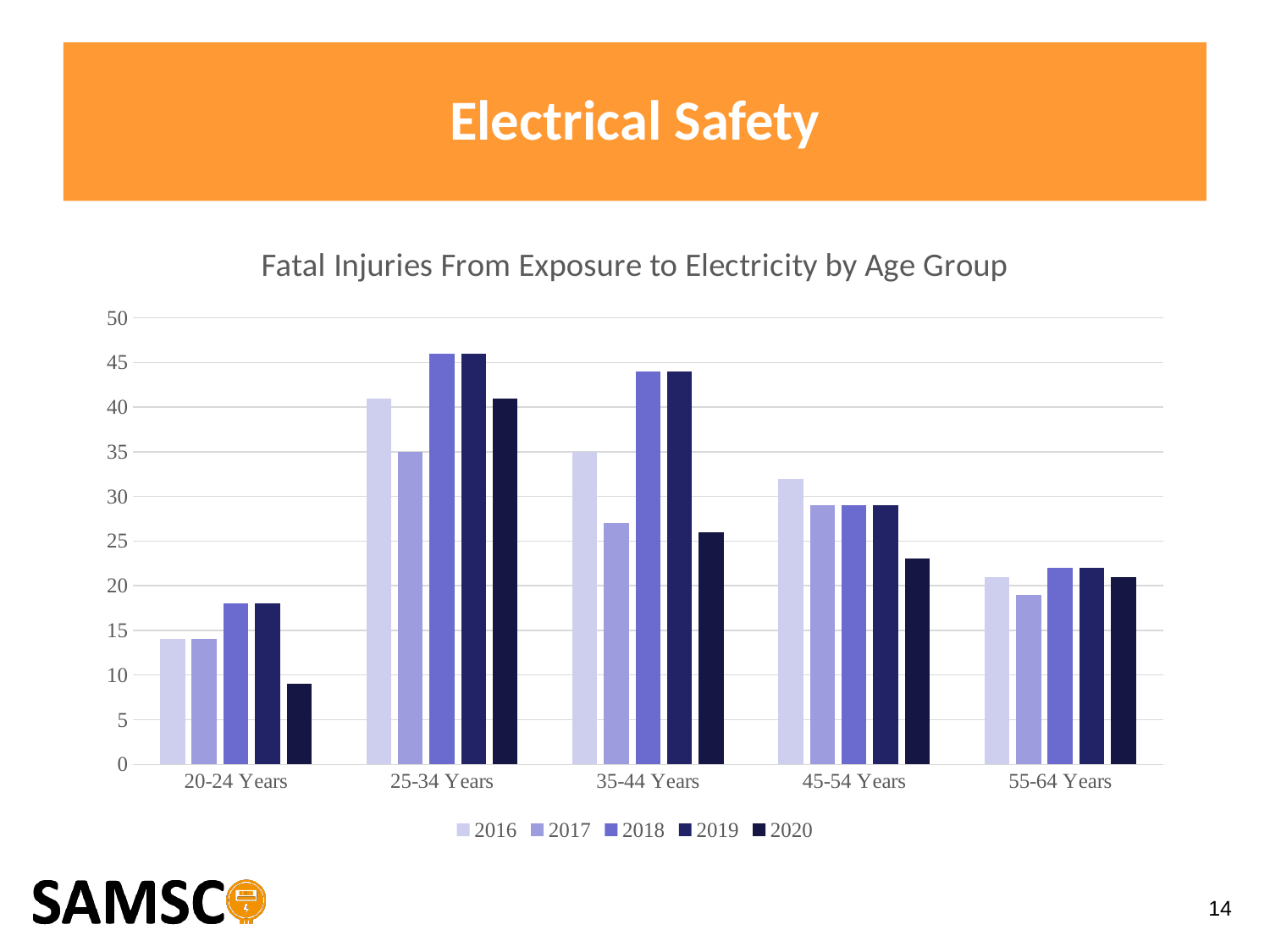
How many series does the legend list? 5 What type of chart is shown on the slide? bar chart Which age group has the highest value for 2018? 25-34 Years Within the 45-54 Years group, which year has the highest value? 2016 For the 35-44 Years group, which is larger: the 2016 value or the 2017 value? 2016 Is the 2016 value for 45-54 Years greater or less than 30? greater What is the title of the chart? Fatal Injuries From Exposure to Electricity by Age Group Which age group has the lowest value for 2020? 20-24 Years How many age groups are shown on the x axis? 5 For the 55-64 Years group, which is larger: the 2016 value or the 2017 value? 2016 Is the 2018 value for 25-34 Years greater or less than 45? greater Is the 2020 value for 20-24 Years greater or less than 10? less